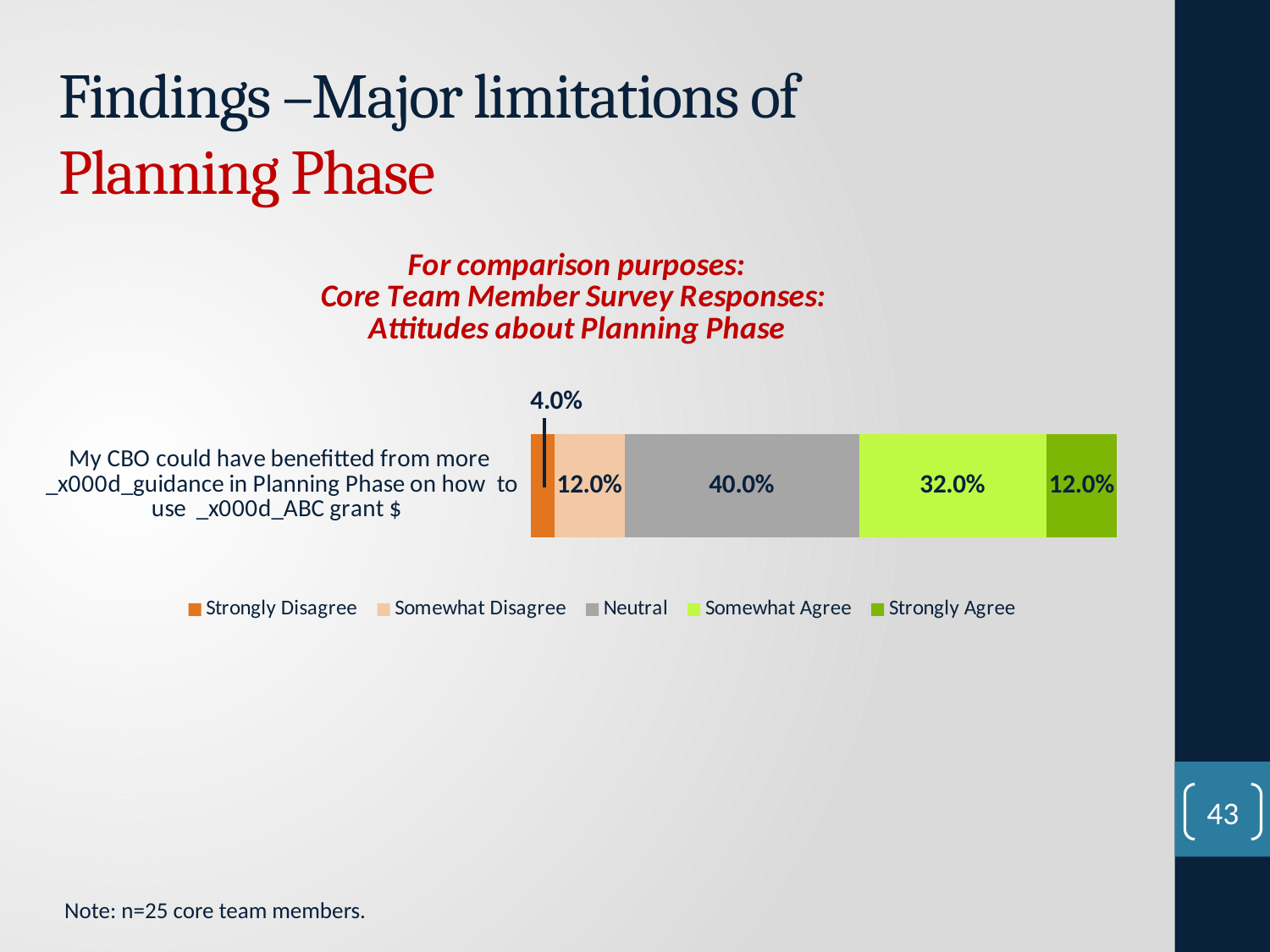
What percentage of core team members responded Neutral to the statement about needing more guidance in Planning Phase? 40.0% What type of chart is shown on the slide? Stacked bar chart Which response category has the largest share of respondents? Neutral What is the combined percentage of respondents who Somewhat Agree or Strongly Agree? 44.0% What is the difference in percentage points between the Neutral and Somewhat Agree responses? 8.0% What percentage of respondents answered Somewhat Agree? 32.0% Which is larger, the Somewhat Disagree share or the Somewhat Agree share? Somewhat Agree What percentage of respondents answered Strongly Agree? 12.0% Which response category has the smallest share of respondents? Strongly Disagree What colour represents the Neutral response in the chart? Gray What percentage of respondents answered Strongly Disagree? 4.0% How many response categories does the legend list? 5